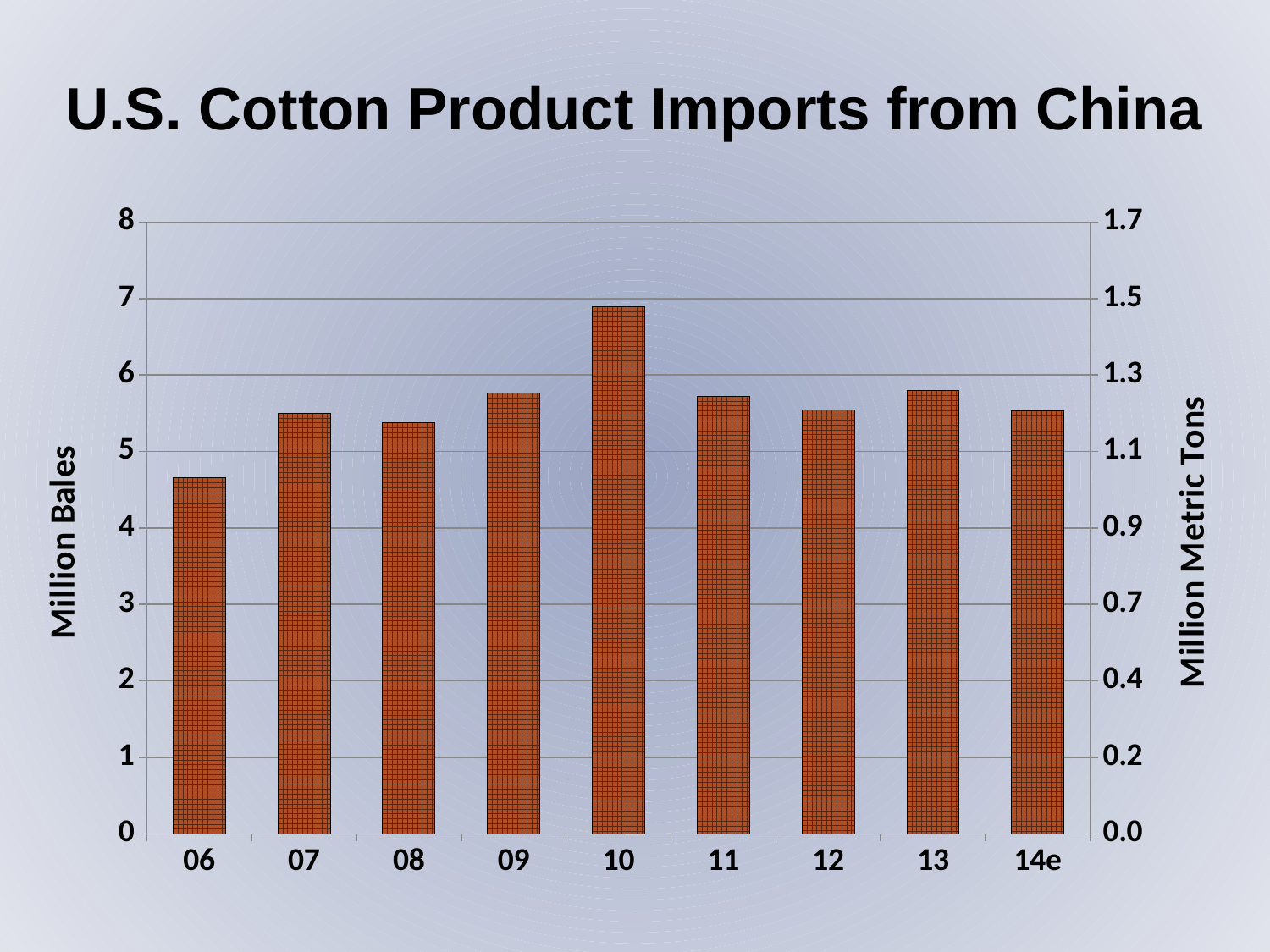
What kind of chart is shown on the slide? bar chart Which is larger, the value for 06 or the value for 07? 07 Which year has the highest U.S. cotton product imports from China? 10 What is the title of the chart? U.S. Cotton Product Imports from China Is the value for 10 greater or less than 6 million bales? greater Which year has the lowest U.S. cotton product imports from China? 06 Is the value for 13 greater or less than 6 million bales? less Which is larger, the value for 10 or the value for 13? 10 Is the value for 07 greater or less than 5 million bales? greater What is the label on the right-hand vertical axis? Million Metric Tons How many years (bars) are shown on the chart? 9